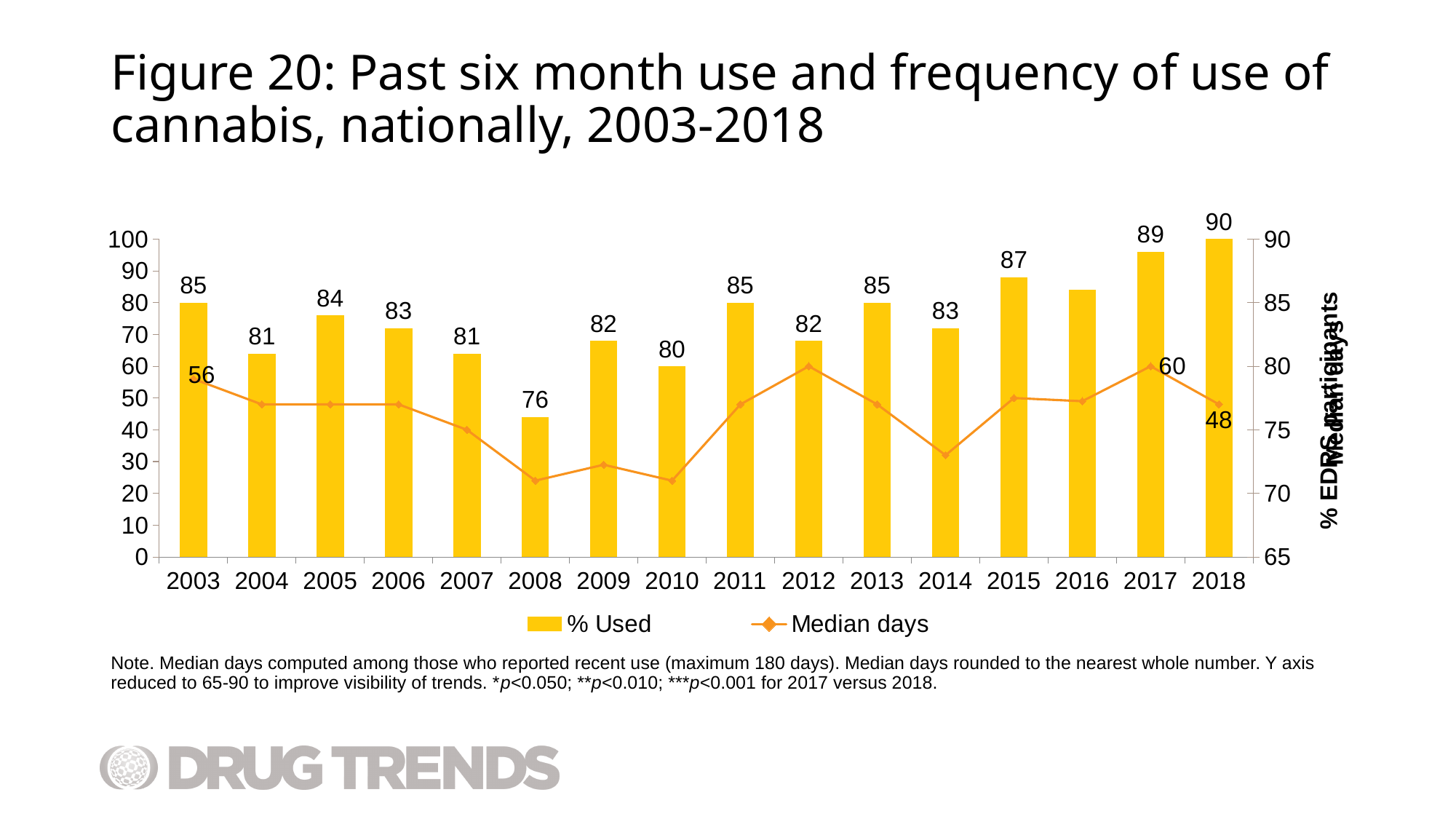
What is the % Used value for 2008? 76 What is the % Used value for 2018? 90 How many years are shown on the x axis? 16 What is the difference between the Median days values for 2017 and 2018? 12 Which year has the larger % Used value, 2004 or 2005? 2005 Which year has the highest % Used value? 2018 How many series does the legend list? 2 Is the Median days value for 2008 greater or less than 30 on the left axis? less What is the Median days value for 2018? 48 What is the Median days value for 2003? 56 What is the difference between the % Used values for 2018 and 2017? 1 Which year has the lowest % Used value? 2008